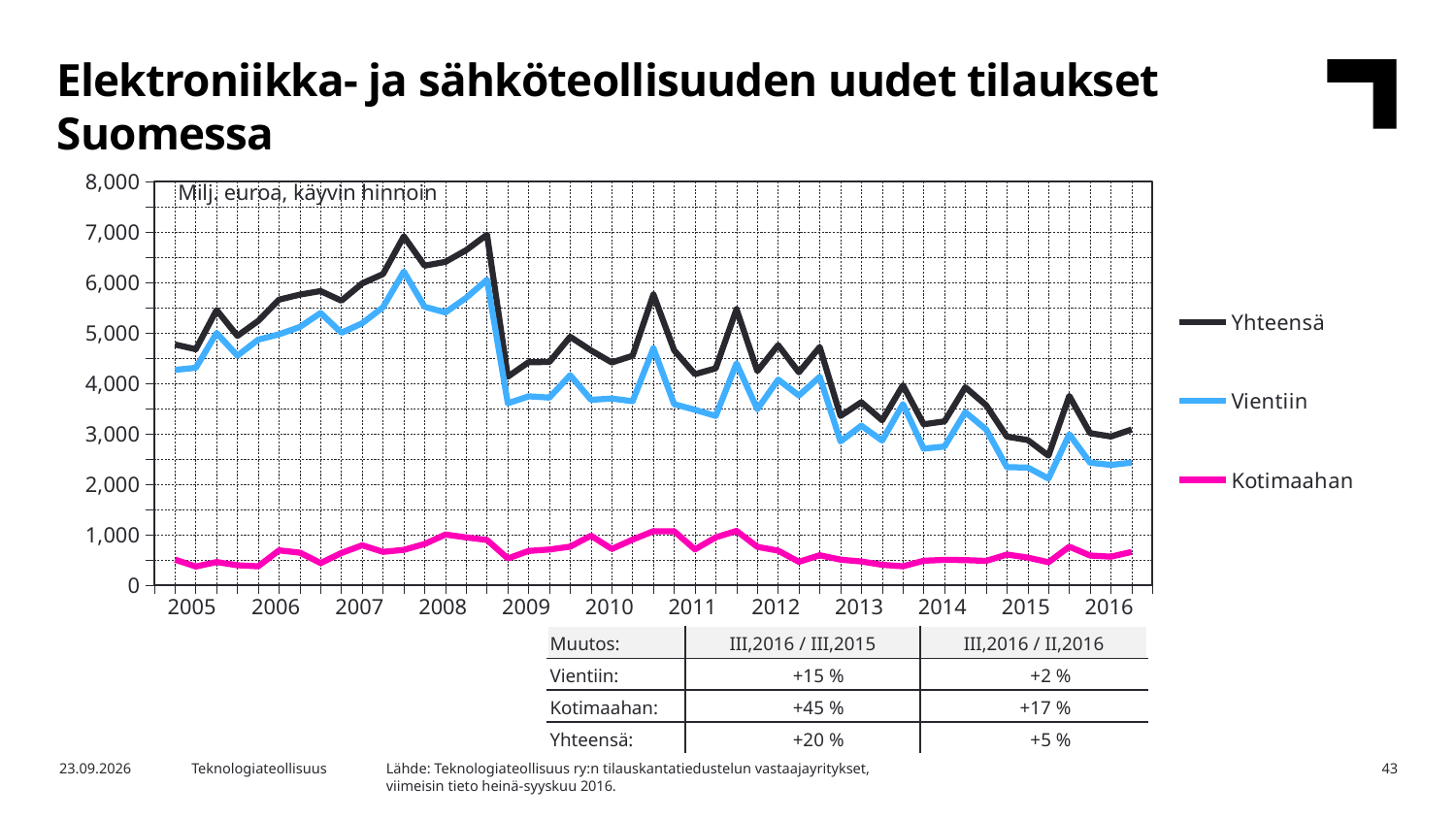
Does the Yhteensä series rise or fall overall from 2009 to 2016? fall What unit label is shown inside the chart area? Milj. euroa, käyvin hinnoin Which series has the lowest values throughout the chart? Kotimaahan Is the value for Kotimaahan in 2010 greater or less than 2,000? less What is the title of the chart? Elektroniikka- ja sähköteollisuuden uudet tilaukset Suomessa Which series has the highest values throughout the chart? Yhteensä What kind of chart is shown on the slide? Line chart Is the peak value for Yhteensä in 2008 greater or less than 6,000? greater Which is larger in 2012, Vientiin or Kotimaahan? Vientiin Is the value for Vientiin in 2016 greater or less than 3,000? less How many series does the legend list? 3